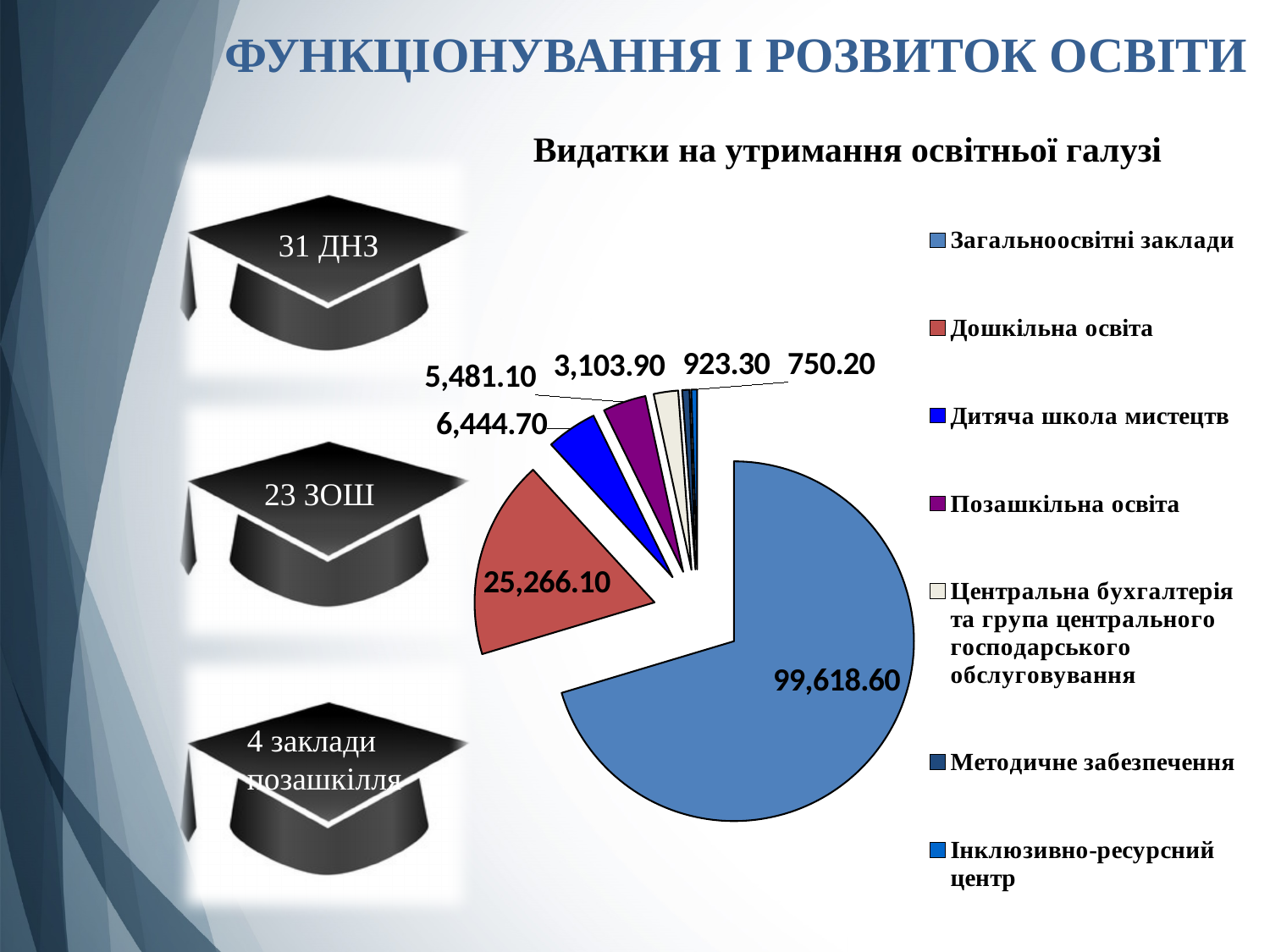
What is the value for Дошкільна освіта? 25,266.10 What is the value for Інклюзивно-ресурсний центр? 750.20 How many slices does the pie chart have? 7 What is the value for Дитяча школа мистецтв? 6,444.70 Which category has the smallest slice of the pie? Інклюзивно-ресурсний центр Which category has the largest slice of the pie? Загальноосвітні заклади What kind of chart is shown on the slide? pie chart What is the value for Позашкільна освіта? 5,481.10 What is the difference between the values for Загальноосвітні заклади and Дошкільна освіта? 74,352.50 What is the value for Загальноосвітні заклади? 99,618.60 Which is larger, the value for Методичне забезпечення or the value for Інклюзивно-ресурсний центр? Методичне забезпечення What is the title of the chart? Видатки на утримання освітньої галузі